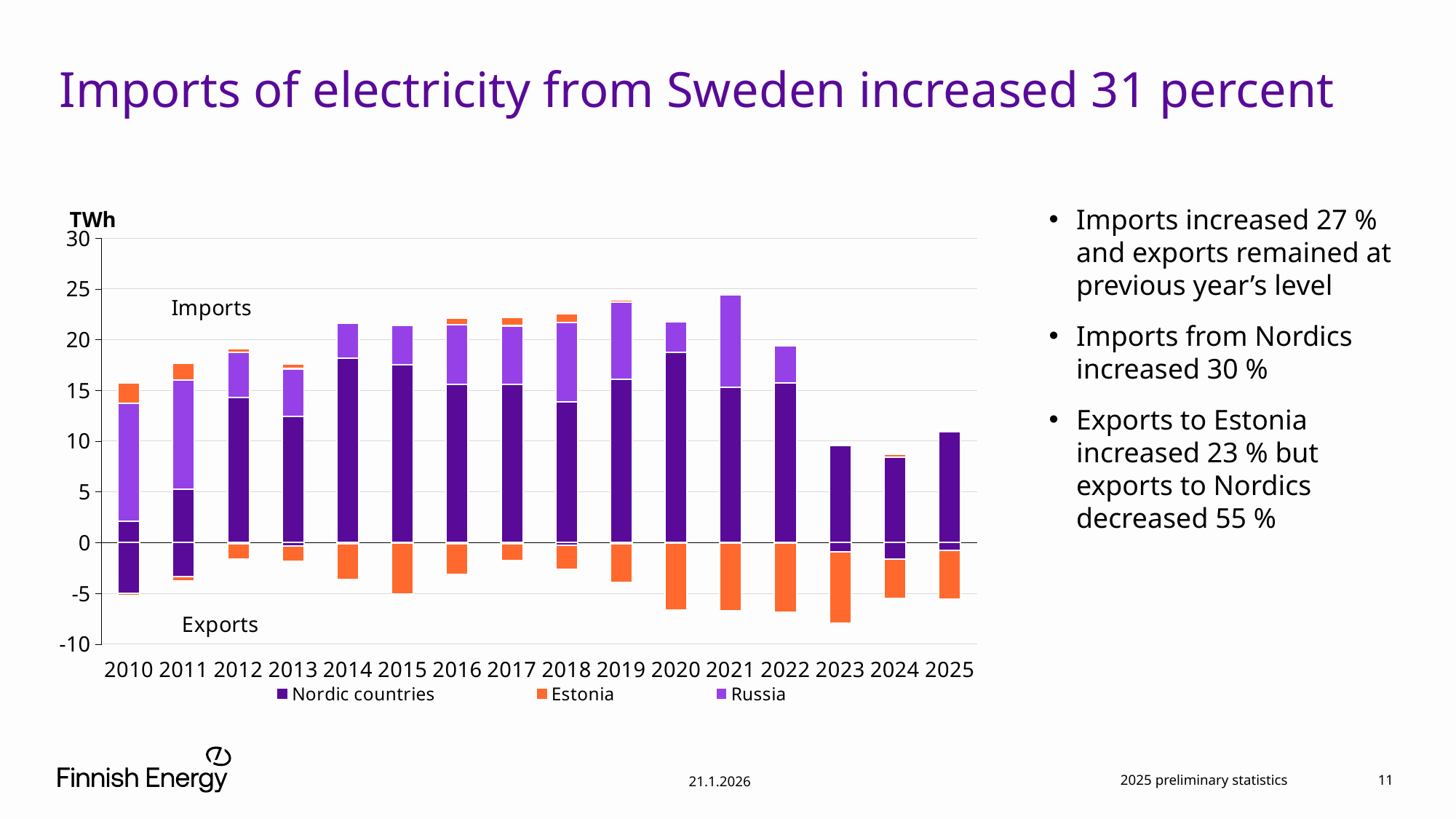
Is the total imports value for 2021 greater or less than 20? greater How many years are shown on the x axis? 16 How many series does the legend list? 3 Is the total imports value for 2010 greater or less than 20? less Is the total imports value for 2024 greater or less than 10? less What unit is shown on the vertical axis? TWh What kind of chart is shown on the slide? Stacked bar chart Which year has the lowest total imports? 2024 Which year has larger imports from Nordic countries, 2020 or 2021? 2020 Which series is shown in orange in the legend? Estonia Which year has the largest total exports (the bar extending furthest below zero)? 2023